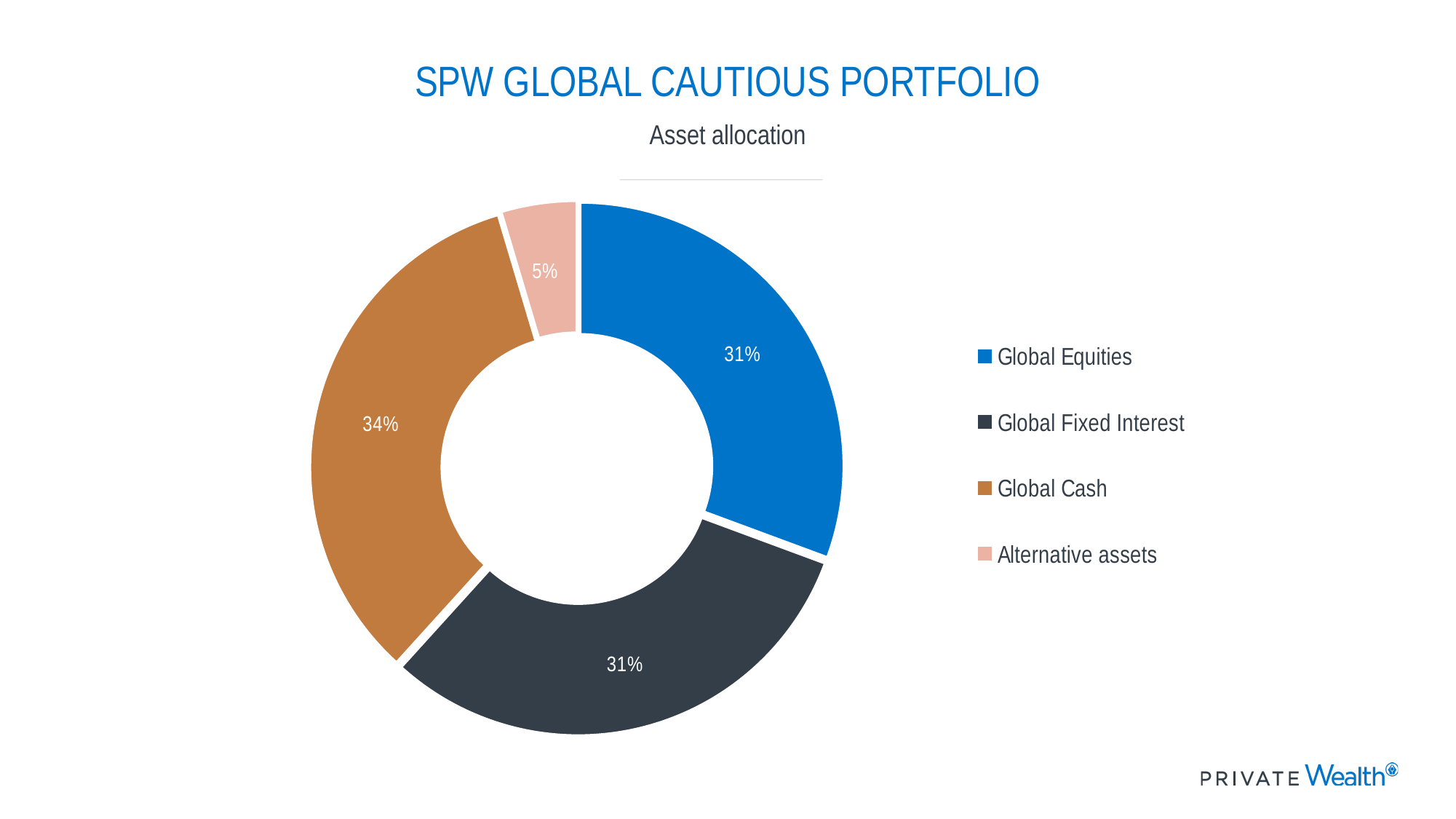
Which asset class has the smallest allocation? Alternative assets What share of the portfolio is allocated to Global Equities? 31% Which is larger, the allocation to Global Cash or to Global Equities? Global Cash What kind of chart is shown on the slide? Doughnut (pie) chart What share of the portfolio is allocated to Alternative assets? 5% How many asset classes are shown in the chart? 4 What is the difference between the Global Cash and Global Equities allocations? 3 percentage points What share of the portfolio is allocated to Global Cash? 34% Which asset class has the largest allocation? Global Cash What is the subtitle of the chart? Asset allocation What is the difference between the Global Cash and Alternative assets allocations? 29 percentage points What share of the portfolio is allocated to Global Fixed Interest? 31%